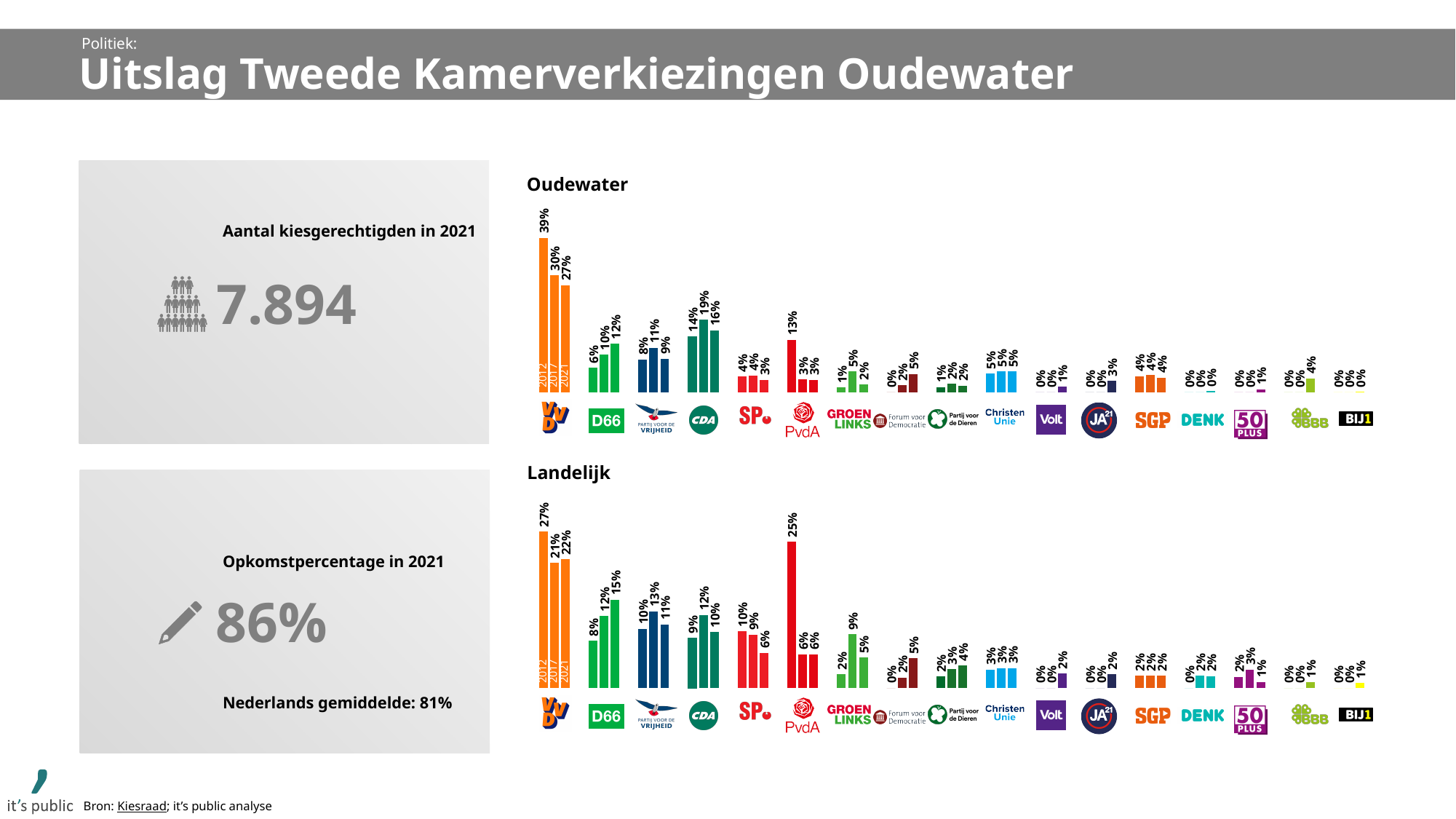
In the Oudewater chart, which party had the highest percentage in 2021? VVD In the Landelijk chart, did D66's percentage rise or fall from 2012 to 2021? Rise In the Oudewater chart, which is larger: the CDA's 2021 percentage or D66's 2021 percentage? CDA's 2021 percentage What kind of chart is the Landelijk chart? Bar chart How many election years are shown for each party in the Oudewater chart? 3 In the Landelijk chart, what percentage did D66 get in 2021? 15% In the Landelijk chart, what is the difference between the PvdA's 2012 and 2017 percentages? 19% In the Oudewater chart, what percentage did the VVD get in 2021? 27% In the Landelijk chart, what percentage did the PvdA get in 2012? 25% In the Oudewater chart, did the VVD's percentage rise or fall from 2012 to 2021? Fall In the Oudewater chart, what is the difference between the VVD's 2012 and 2021 percentages? 12% In the Oudewater chart, what percentage did the CDA get in 2017? 19%